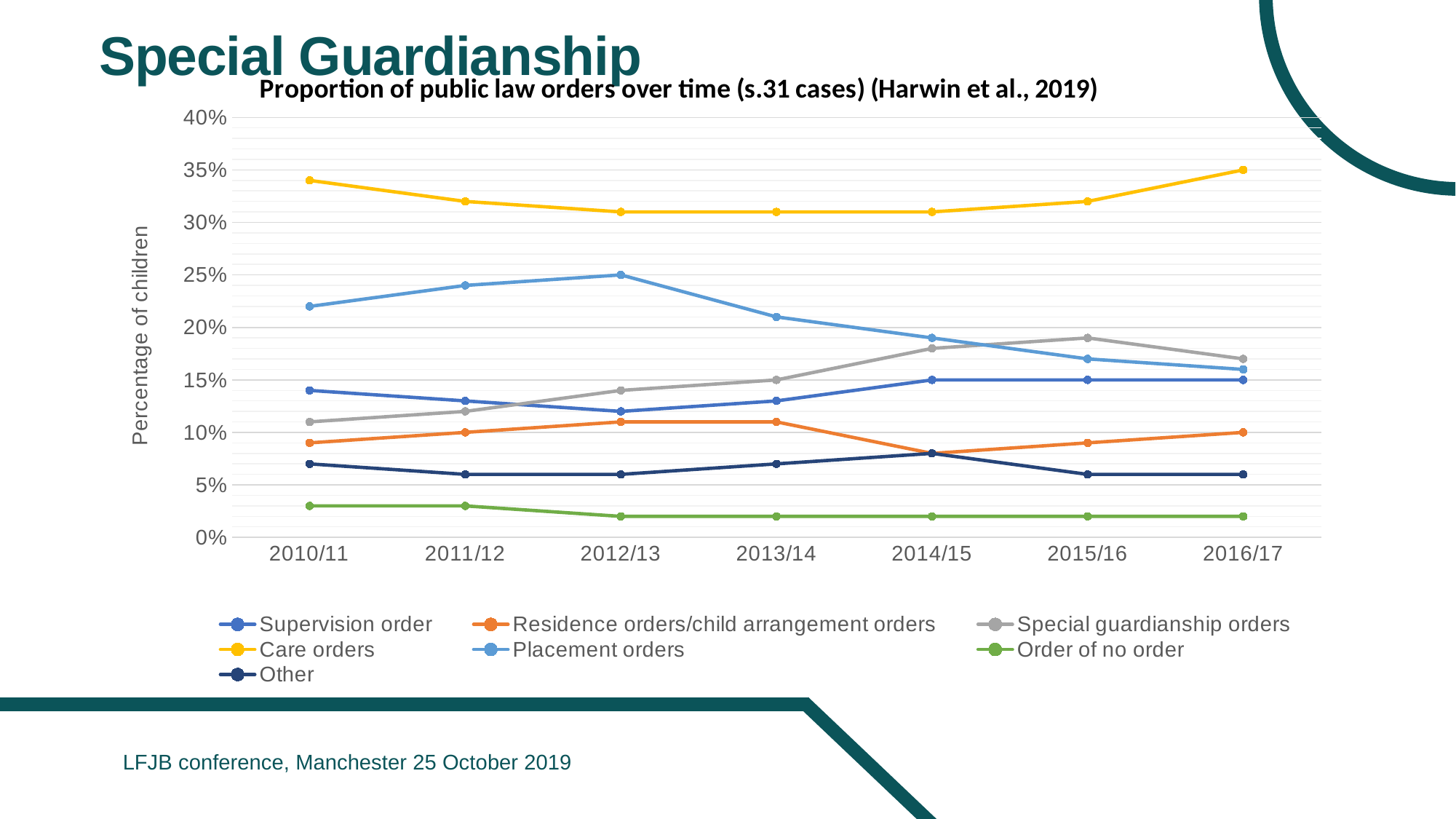
What is the value for Supervision order in 2015/16? 15% How many series does the legend list? 7 Do the values for Placement orders rise or fall from 2012/13 to 2016/17? fall What is the value for Care orders in 2016/17? 35% Which series has the highest value in 2016/17? Care orders What type of chart is shown on the slide? line chart What is the title of the chart? Proportion of public law orders over time (s.31 cases) (Harwin et al., 2019) Which series has the lowest value in 2013/14? Order of no order Is the value for Placement orders in 2016/17 greater or less than 20%? less How many time periods are shown on the x axis? 7 What is the value for Placement orders in 2012/13? 25% Is the value for Care orders in 2010/11 greater or less than 30%? greater